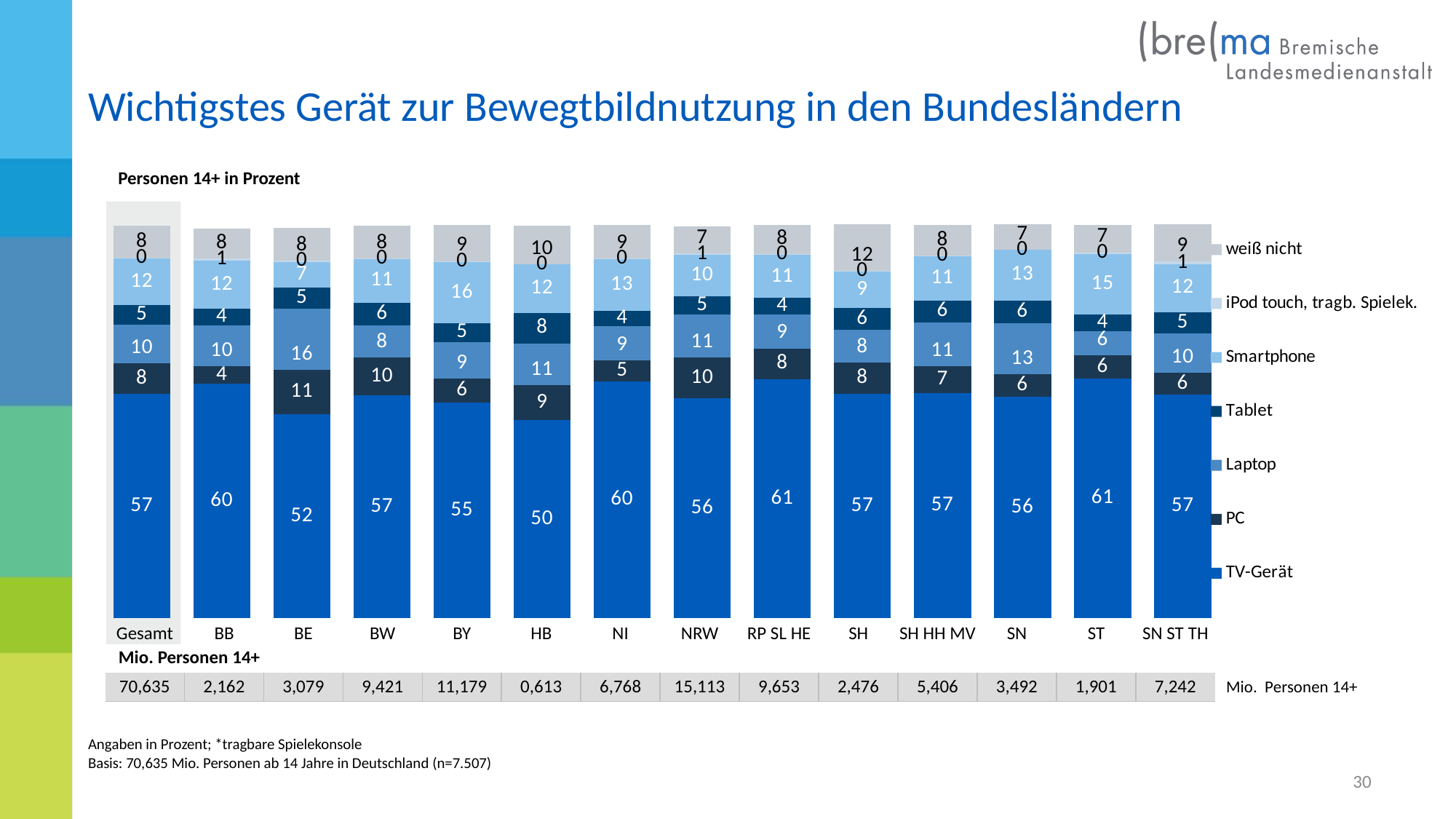
What is the Smartphone value for BY? 16 Which category has the highest weiß nicht value? SH What is the Mio. Personen 14+ figure shown for NRW? 15,113 What is the Laptop value for BE? 16 What is the difference between the TV-Gerät values for BB and BE? 8 How many categories (bars) are shown along the x axis? 14 What kind of chart is shown on the slide? Stacked bar chart How many series does the legend list? 7 Which category has the lowest TV-Gerät value? HB Which category has the highest Smartphone value? BY Which is larger, the PC value for BW or the PC value for BB? BW What is the TV-Gerät value for HB? 50